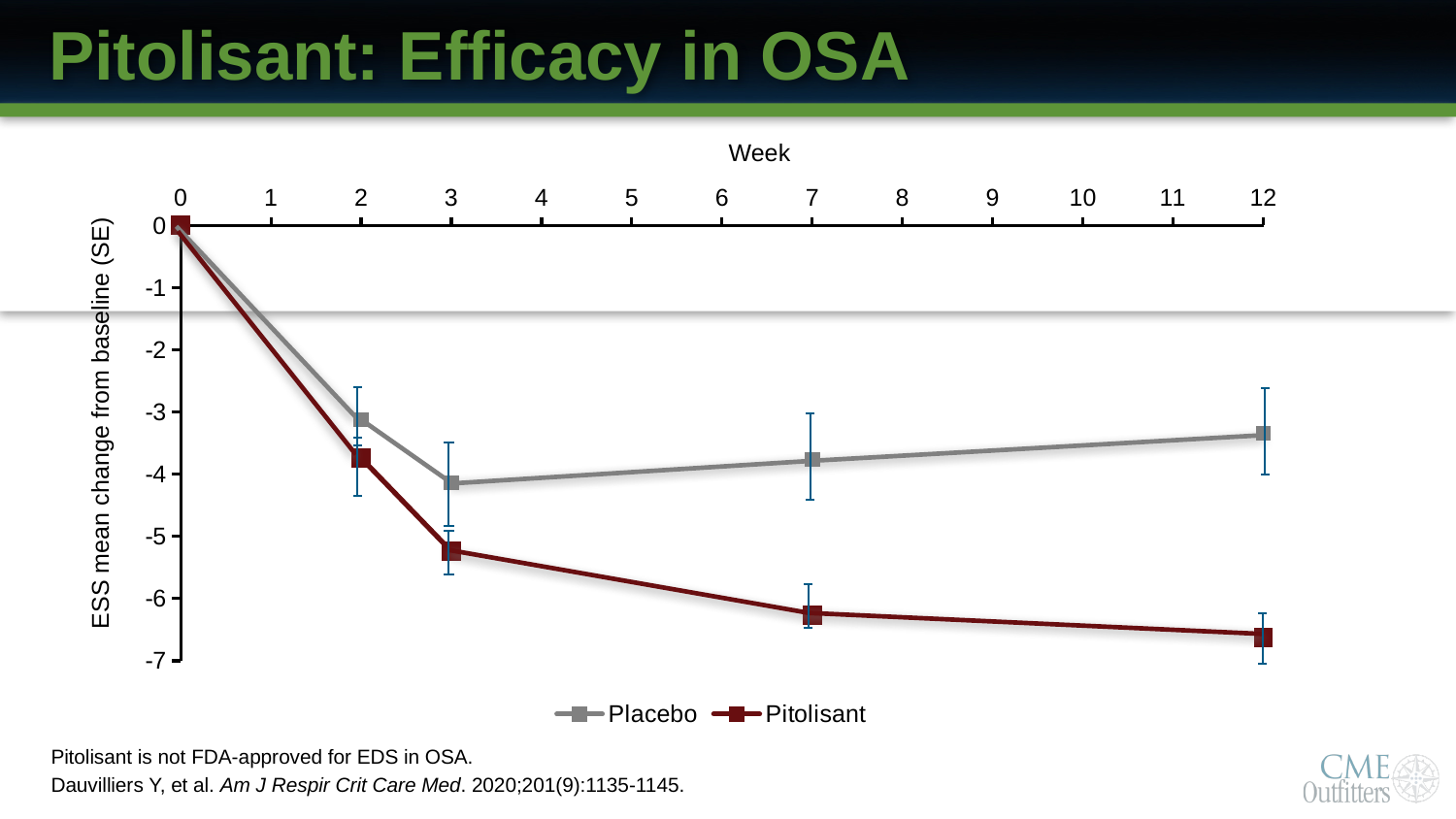
At which week does the Pitolisant series reach its lowest value? 12 Is the value for Pitolisant at week 2 greater or less than -3? less How many series does the legend list? 2 At week 12, which series has the lower ESS mean change from baseline, Placebo or Pitolisant? Pitolisant Which two series are listed in the legend? Placebo and Pitolisant Is the value for Placebo at week 12 greater or less than -4? greater What is the ESS mean change from baseline for Pitolisant at week 0? 0 What kind of chart is shown on the slide? line chart Is the value for Pitolisant at week 12 greater or less than -6? less What is the title of the x axis? Week Does the Pitolisant series rise or fall from week 0 to week 12? fall How many data points are plotted for the Pitolisant series? 5